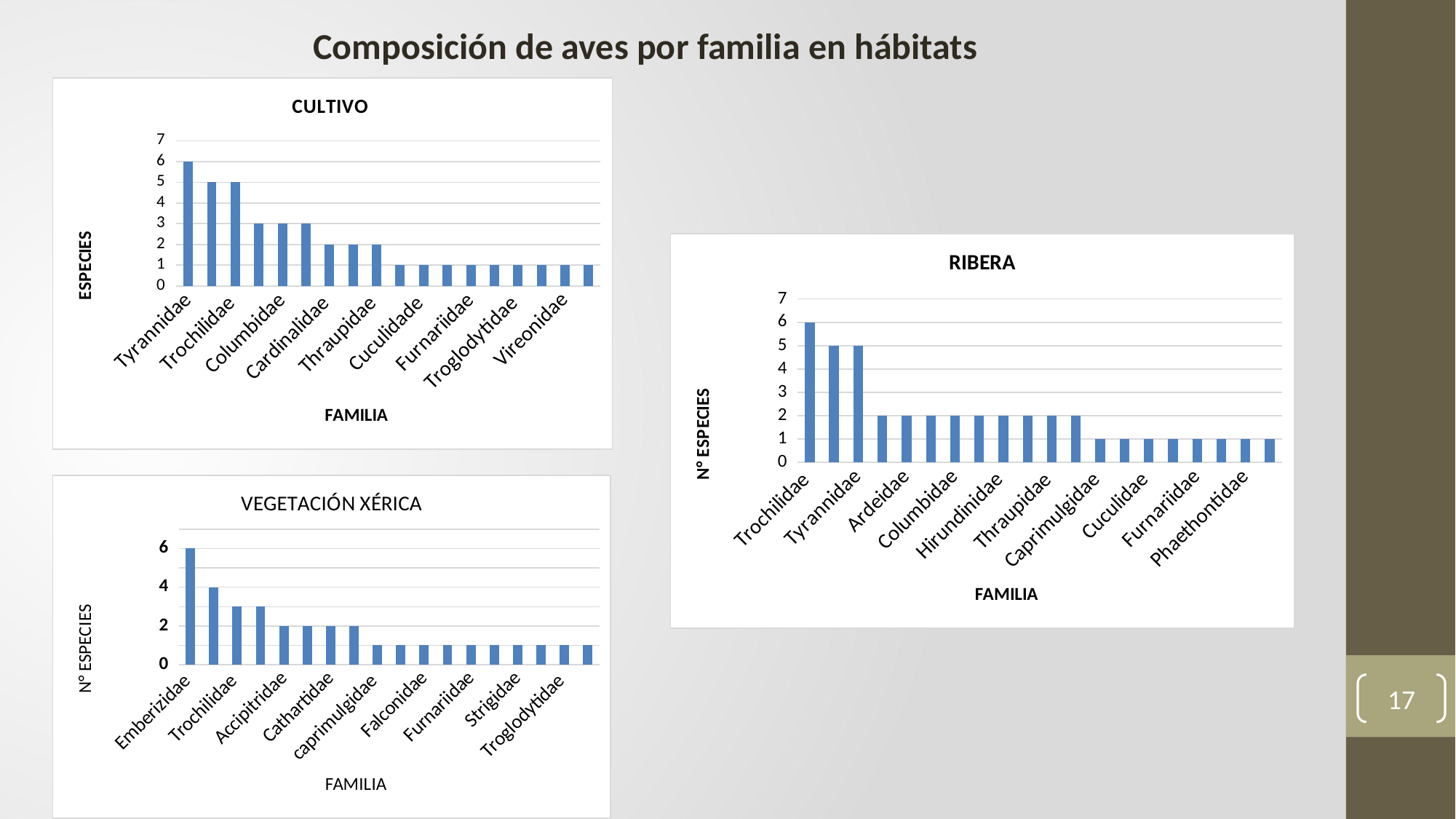
In the CULTIVO chart, which has more species, Columbidae or Cardinalidae? Columbidae In the CULTIVO chart, which family has the highest number of species? Tyrannidae In the RIBERA chart, how many species are shown for Tyrannidae? 5 In the CULTIVO chart, how many species are shown for Tyrannidae? 6 In the CULTIVO chart, what is the difference between the values for Tyrannidae and Columbidae? 3 In the VEGETACIÓN XÉRICA chart, which family has the highest number of species? Emberizidae What kind of chart is the RIBERA chart? bar chart In the RIBERA chart, what is the difference between the values for Trochilidae and Caprimulgidae? 5 In the RIBERA chart, which family has the highest number of species? Trochilidae In the VEGETACIÓN XÉRICA chart, is the value for Trochilidae greater or less than 2? greater In the CULTIVO chart, how many species are shown for Trochilidae? 5 In the CULTIVO chart, do the values rise or fall from left to right along the x axis? fall